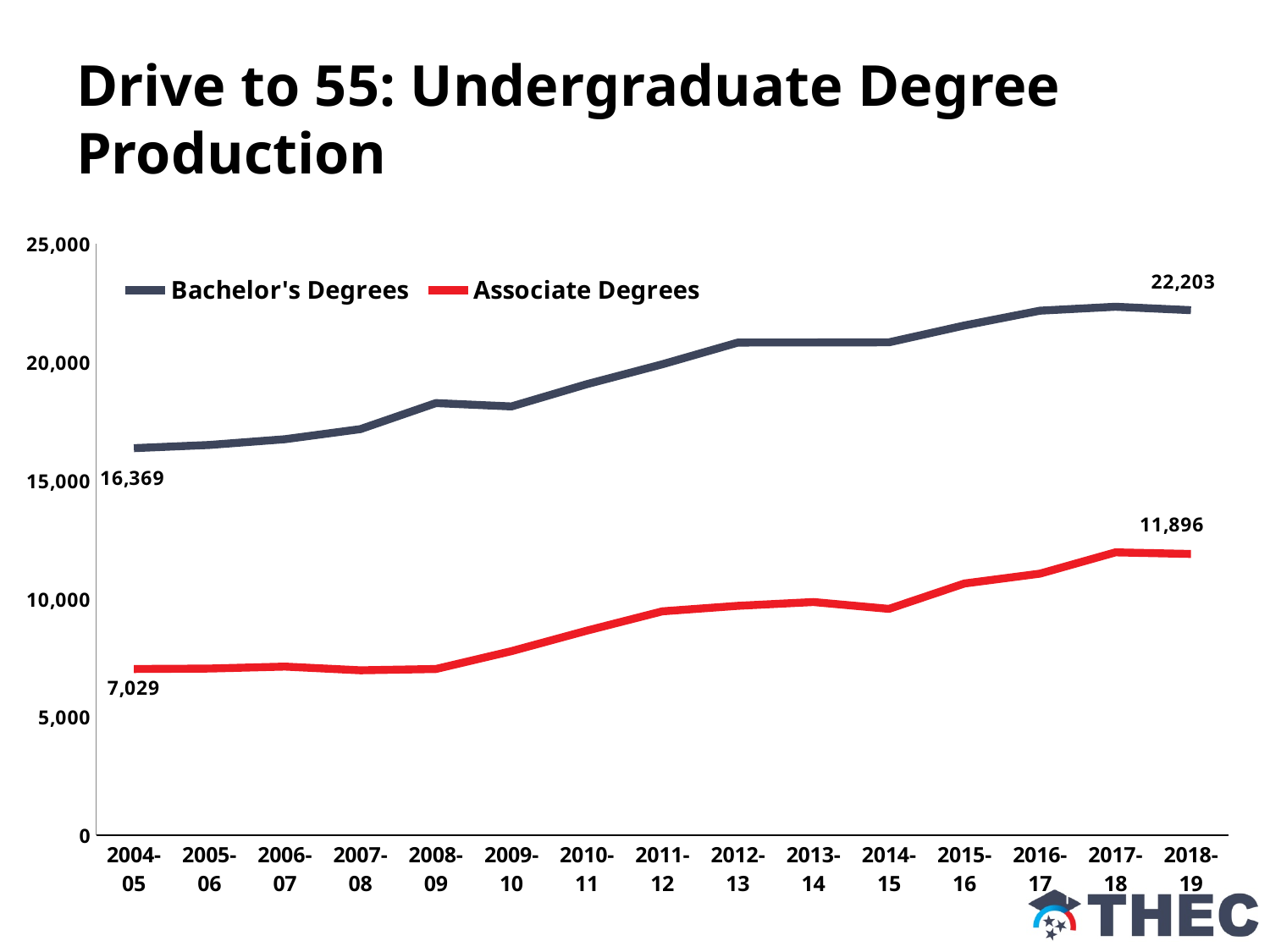
What is the value for Associate Degrees in 2018-19? 11,896 How many series does the legend list? 2 How many academic years are shown on the x axis? 15 By how much did Associate Degrees increase from 2004-05 to 2018-19? 4,867 Is the value for Bachelor's Degrees in 2012-13 greater or less than 20,000? greater What is the value for Bachelor's Degrees in 2004-05? 16,369 What is the value for Bachelor's Degrees in 2018-19? 22,203 Is the value for Associate Degrees in 2008-09 greater or less than 10,000? less What is the value for Associate Degrees in 2004-05? 7,029 In 2018-19, which series has the larger value, Bachelor's Degrees or Associate Degrees? Bachelor's Degrees By how much did Bachelor's Degrees increase from 2004-05 to 2018-19? 5,834 What kind of chart is shown on the slide? line chart